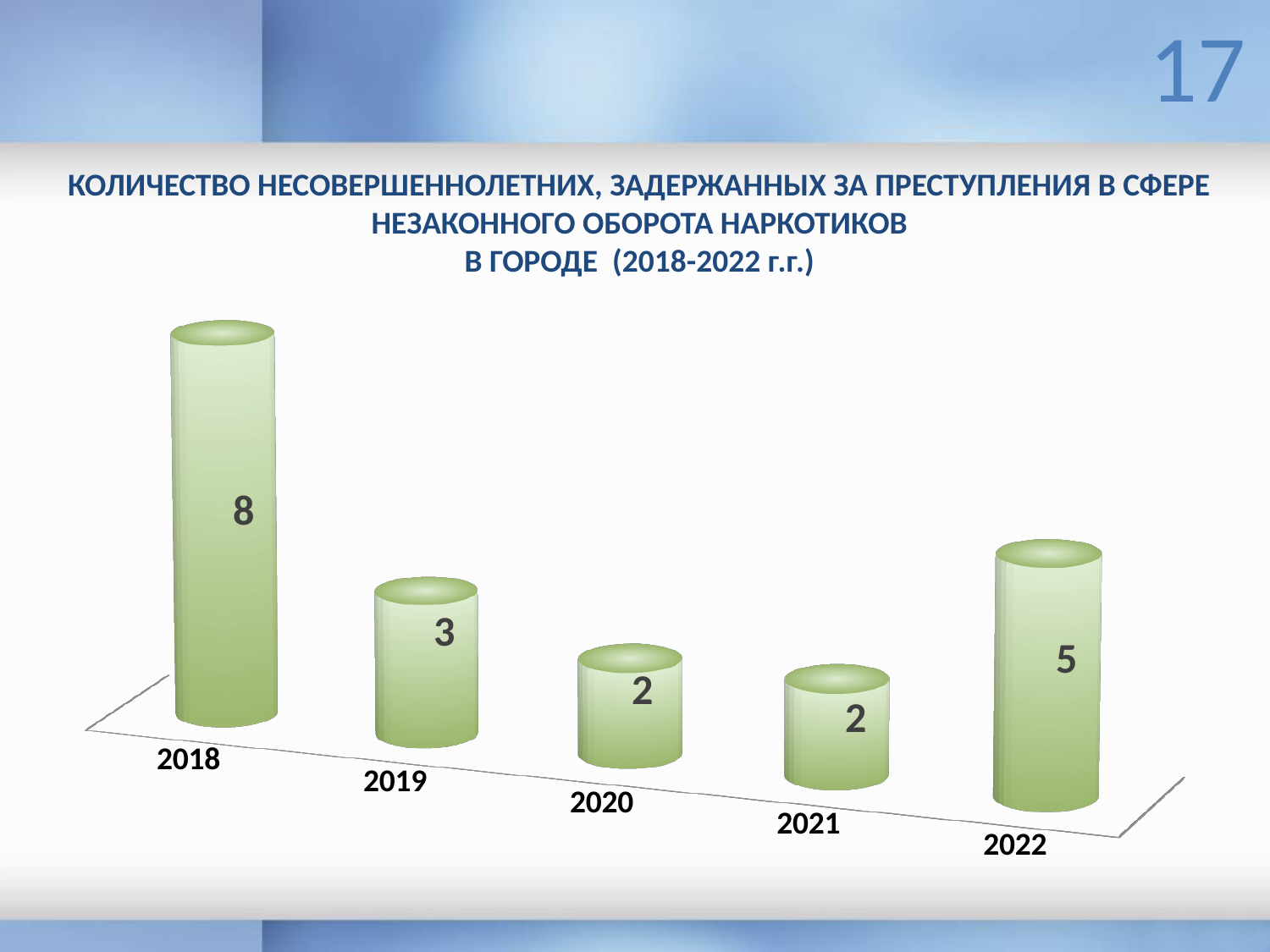
What is the value for 2022? 5 How many years are shown on the chart? 5 Which year has the highest value? 2018 What is the value for 2018? 8 What colour are the bars on the chart? green What is the value for 2021? 2 What is the value for 2019? 3 Do the values rise or fall from 2018 to 2021? fall What is the difference between the values for 2019 and 2020? 1 Which is larger, the value for 2019 or the value for 2022? 2022 What kind of chart is shown on the slide? bar chart What is the difference between the values for 2018 and 2022? 3